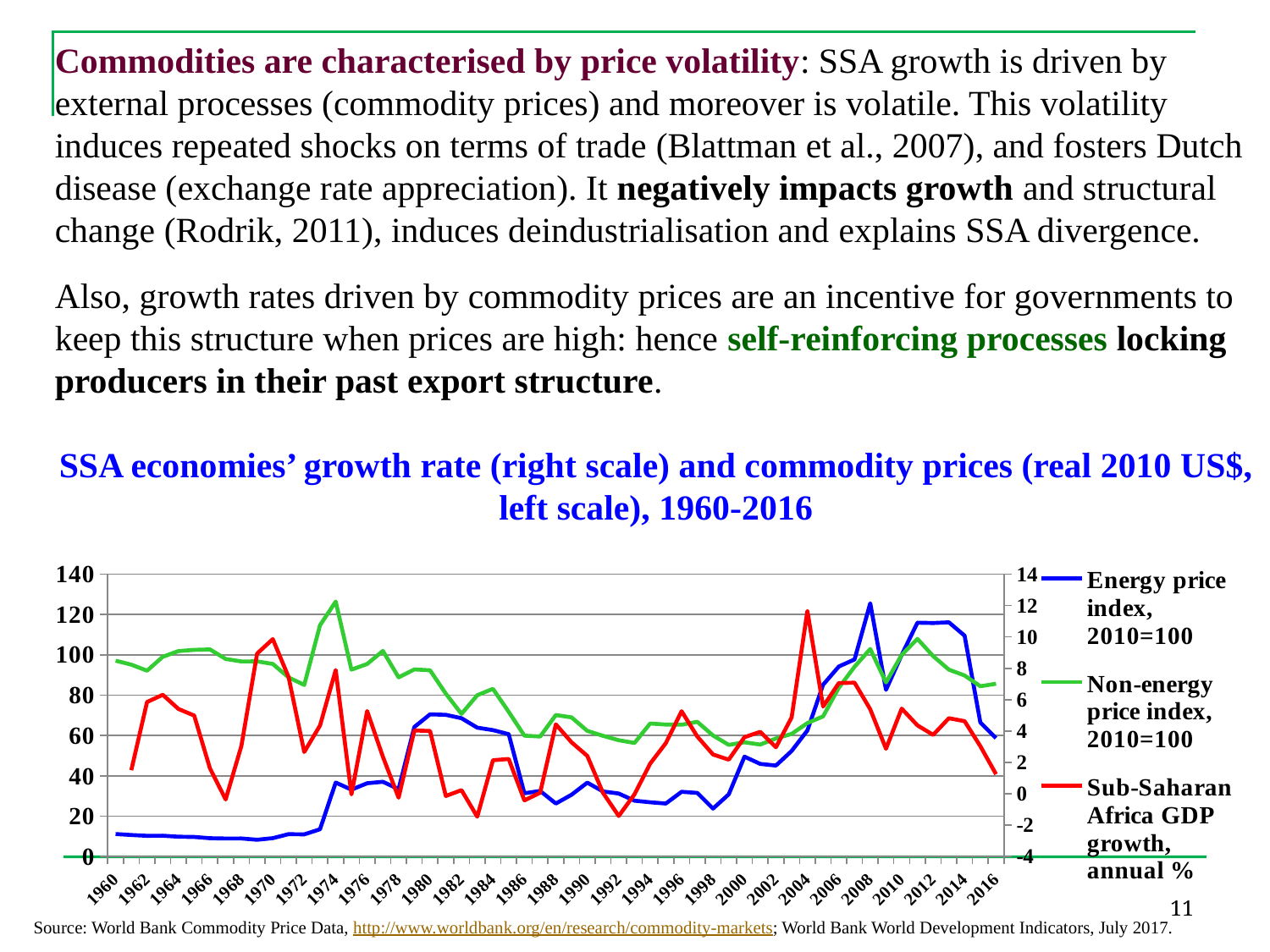
What is the highest value shown on the left-hand axis? 140 Is the Energy price index value for 1998 greater or less than 40? less In which year does the Energy price index reach its highest value? 2008 Which series is plotted in red? Sub-Saharan Africa GDP growth, annual % In 1974, which is higher: the Energy price index or the Non-energy price index? Non-energy price index Is the Energy price index value for 1960 greater or less than 20? less In which year does the Non-energy price index reach its highest value? 1974 In which year does Sub-Saharan Africa GDP growth reach its highest value? 2004 How many series does the chart legend list? 3 What kind of chart is shown on the slide? Line chart Is the Non-energy price index value for 1974 greater or less than 100? greater